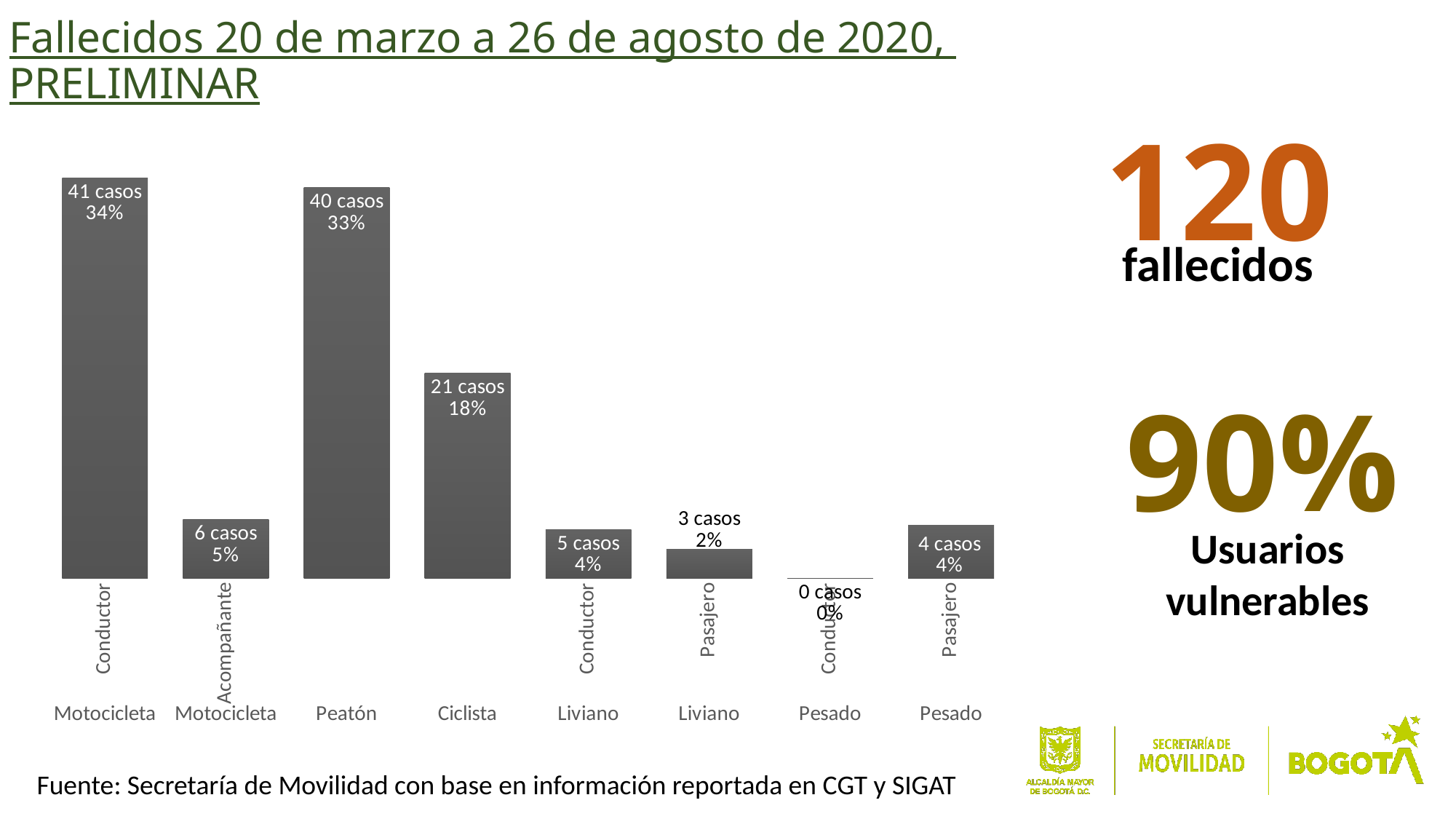
What type of chart is shown on the slide? Bar chart What is the difference in cases between Motocicleta Conductor and Peatón? 1 What percentage is shown for Motocicleta Acompañante? 5% How many cases are shown for Ciclista? 21 casos What is the total number of fallecidos stated on the slide? 120 What is the difference in cases between Ciclista and Liviano Conductor? 16 Which category has the highest number of cases? Motocicleta Conductor Which category has the lowest number of cases? Pesado Conductor Which has more cases, Liviano Pasajero or Pesado Pasajero? Pesado Pasajero How many categories are shown in the bar chart? 8 What percentage is shown for Peatón? 33% How many cases are shown for Motocicleta Conductor? 41 casos